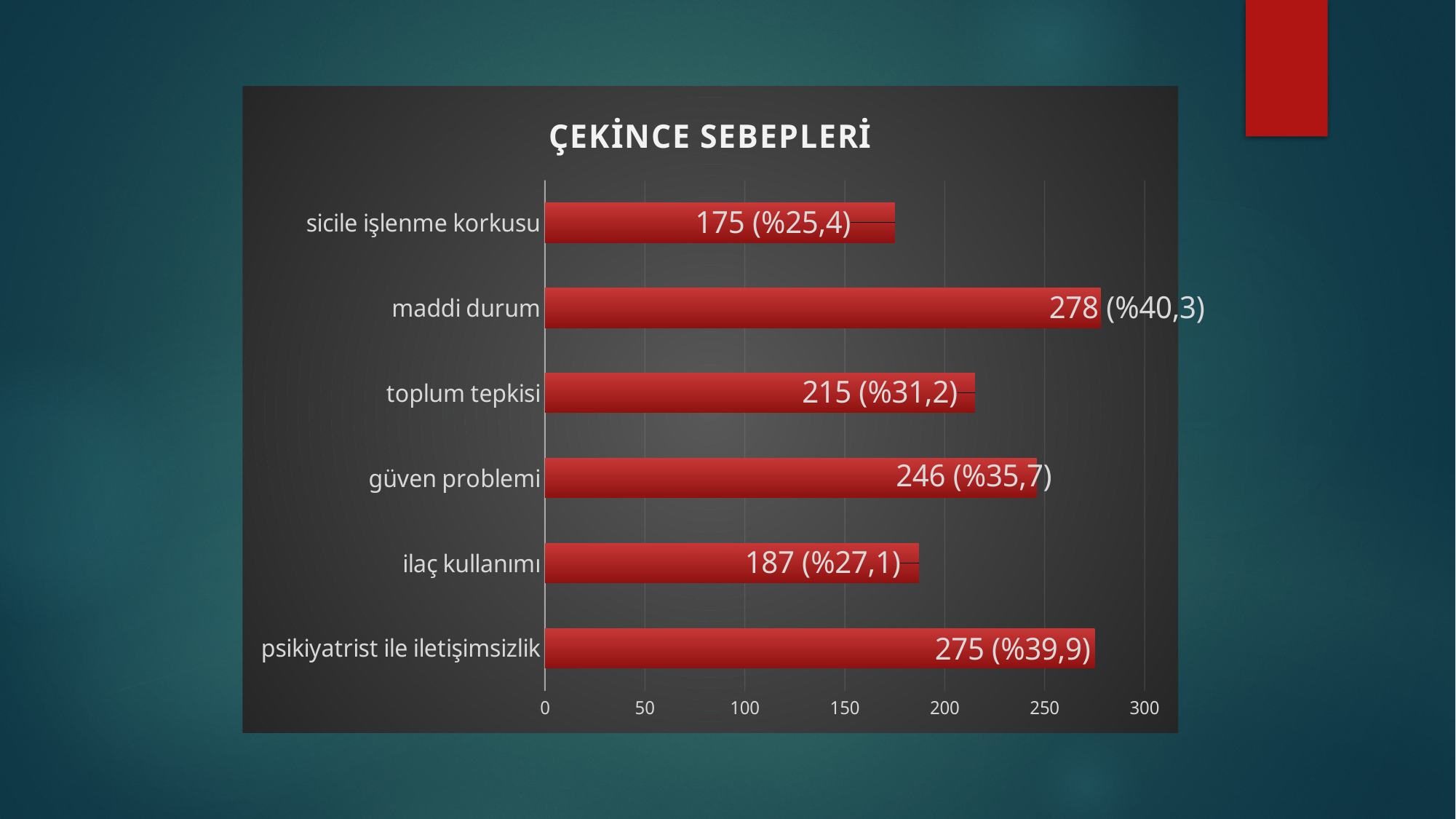
Which is larger, the value for "toplum tepkisi" or the value for "güven problemi"? güven problemi What kind of chart is shown on the slide? bar chart Which category has the lowest value? sicile işlenme korkusu What is the title of the chart? ÇEKİNCE SEBEPLERİ Which category has the highest value? maddi durum What is the value shown for "maddi durum"? 278 (%40,3) What is the value shown for "psikiyatrist ile iletişimsizlik"? 275 (%39,9) What is the difference between the values for "güven problemi" and "ilaç kullanımı"? 59 How many categories are shown in the chart? 6 What is the value shown for "toplum tepkisi"? 215 (%31,2) Is the value for "sicile işlenme korkusu" greater or less than 200? less What percentage is shown next to "ilaç kullanımı"? %27,1